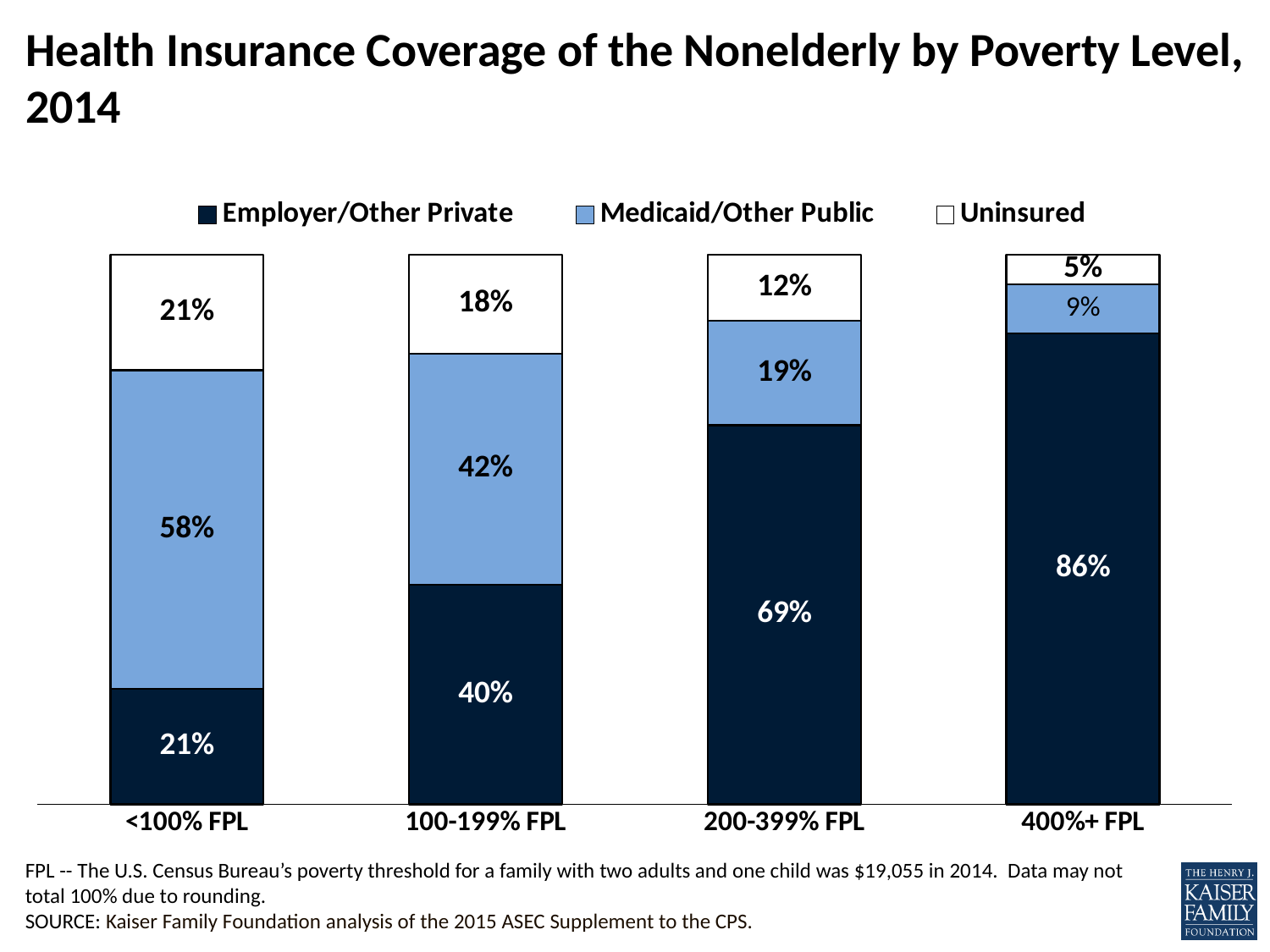
What kind of chart is shown on the slide? Stacked bar chart Which poverty level group has the lowest Uninsured share? 400%+ FPL Which poverty level group has the highest Employer/Other Private share? 400%+ FPL What is the Employer/Other Private share for the <100% FPL group? 21% Does the Employer/Other Private share rise or fall as poverty level increases from <100% FPL to 400%+ FPL? Rise How many series does the legend list? 3 What is the Medicaid/Other Public share for the 400%+ FPL group? 9% Which is larger: the Medicaid/Other Public share for <100% FPL or for 100-199% FPL? <100% FPL What is the Medicaid/Other Public share for the 100-199% FPL group? 42% How many poverty level groups are shown on the x axis? 4 What is the Uninsured share for the 200-399% FPL group? 12% What is the difference between the Employer/Other Private share for 400%+ FPL and for 200-399% FPL? 17%